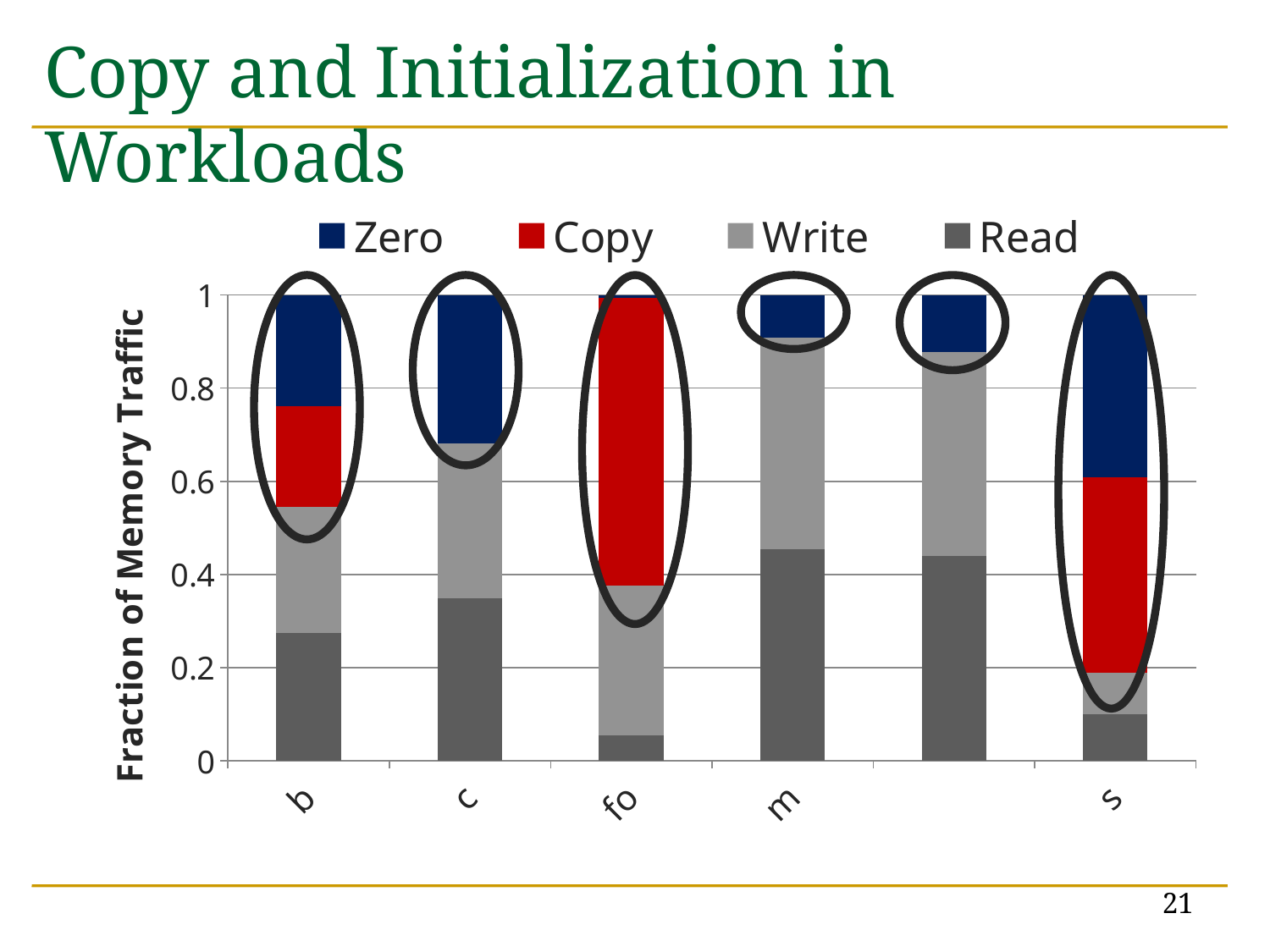
What is the total height of the stacked bar for b? 1 Which bar has the largest Copy segment? fo What kind of chart is shown on the slide? stacked bar chart How many bars are plotted in the chart? 6 Which bar has the largest Zero segment? s Is the Read value for b greater or less than 0.4? less Is the Read value for m greater or less than 0.4? greater Which is larger, the Read segment for m or the Read segment for fo? m What is the title of the y axis? Fraction of Memory Traffic Which legend entry is shown in red? Copy Is the Read value for fo greater or less than 0.2? less How many series does the legend list? 4